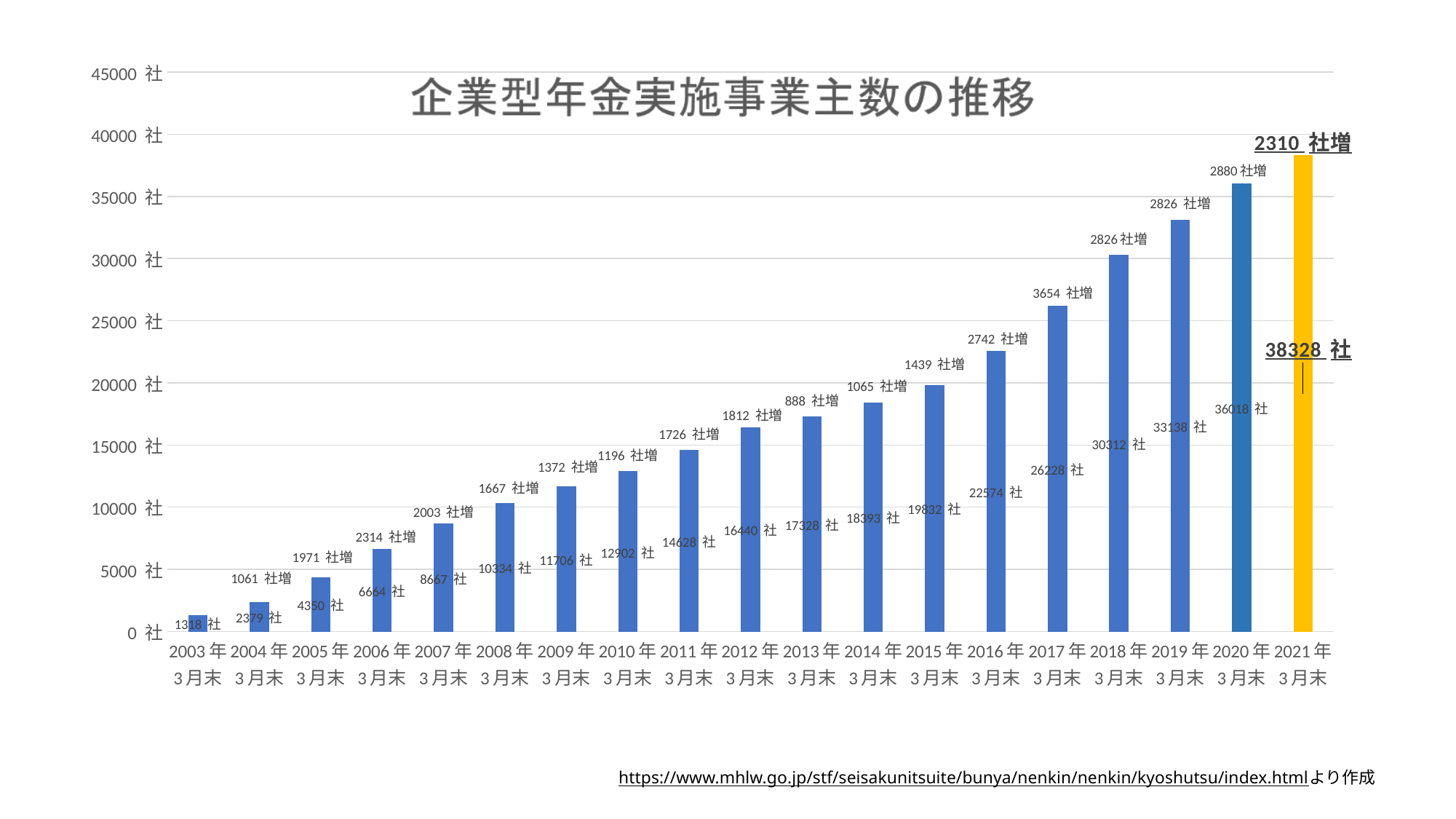
What kind of chart is this? bar chart What is the value for 2016年3月末? 22574 社 How many years (bars) are shown on the x axis? 19 What is the labelled increase (社増) shown above the 2017年3月末 bar? 3654 社増 What is the value for 2021年3月末? 38328 社 Do the values rise or fall from 2003 to 2021? rise Which is larger, the value for 2012年3月末 or the value for 2014年3月末? 2014年3月末 Which year has the lowest value? 2003年3月末 Which year has the highest value? 2021年3月末 What is the value for 2003年3月末? 1318 社 What is the difference between the values for 2021年3月末 and 2020年3月末? 2310 社 Is the value for 2015年3月末 greater or less than 20000? less